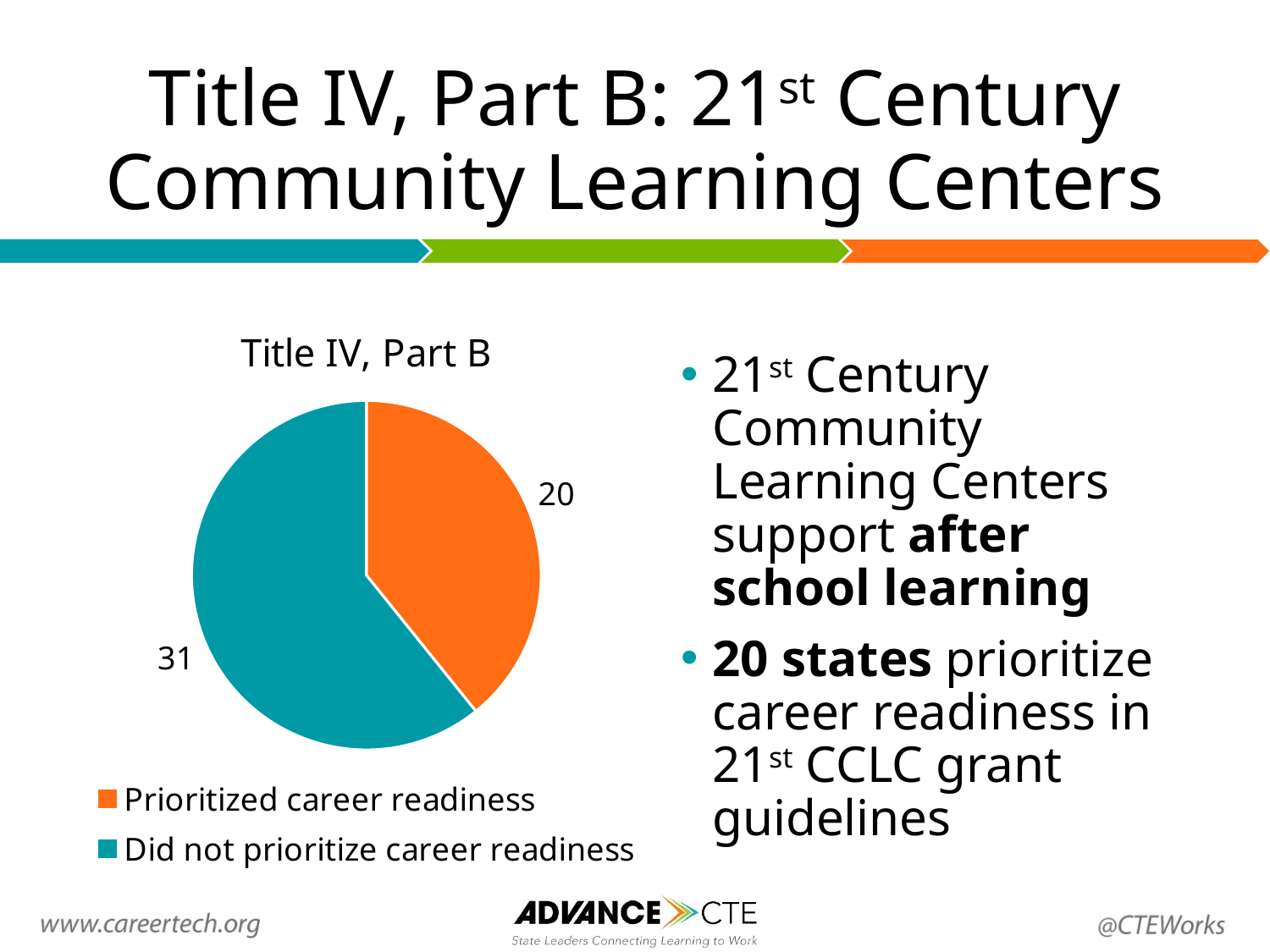
How many states prioritized career readiness? 20 What type of chart is shown on the slide? pie chart What is the total of the two slices in the pie chart? 51 What is the chart's title? Title IV, Part B Is the value for 'Prioritized career readiness' larger or smaller than the value for 'Did not prioritize career readiness'? smaller What is the difference between the number of states that did not prioritize career readiness and those that did? 11 How many states did not prioritize career readiness? 31 How many slices does the pie chart have? 2 How many entries does the legend list? 2 Which colour represents 'Did not prioritize career readiness' in the pie chart? teal Which category has the larger slice? Did not prioritize career readiness Which category has the smaller slice? Prioritized career readiness